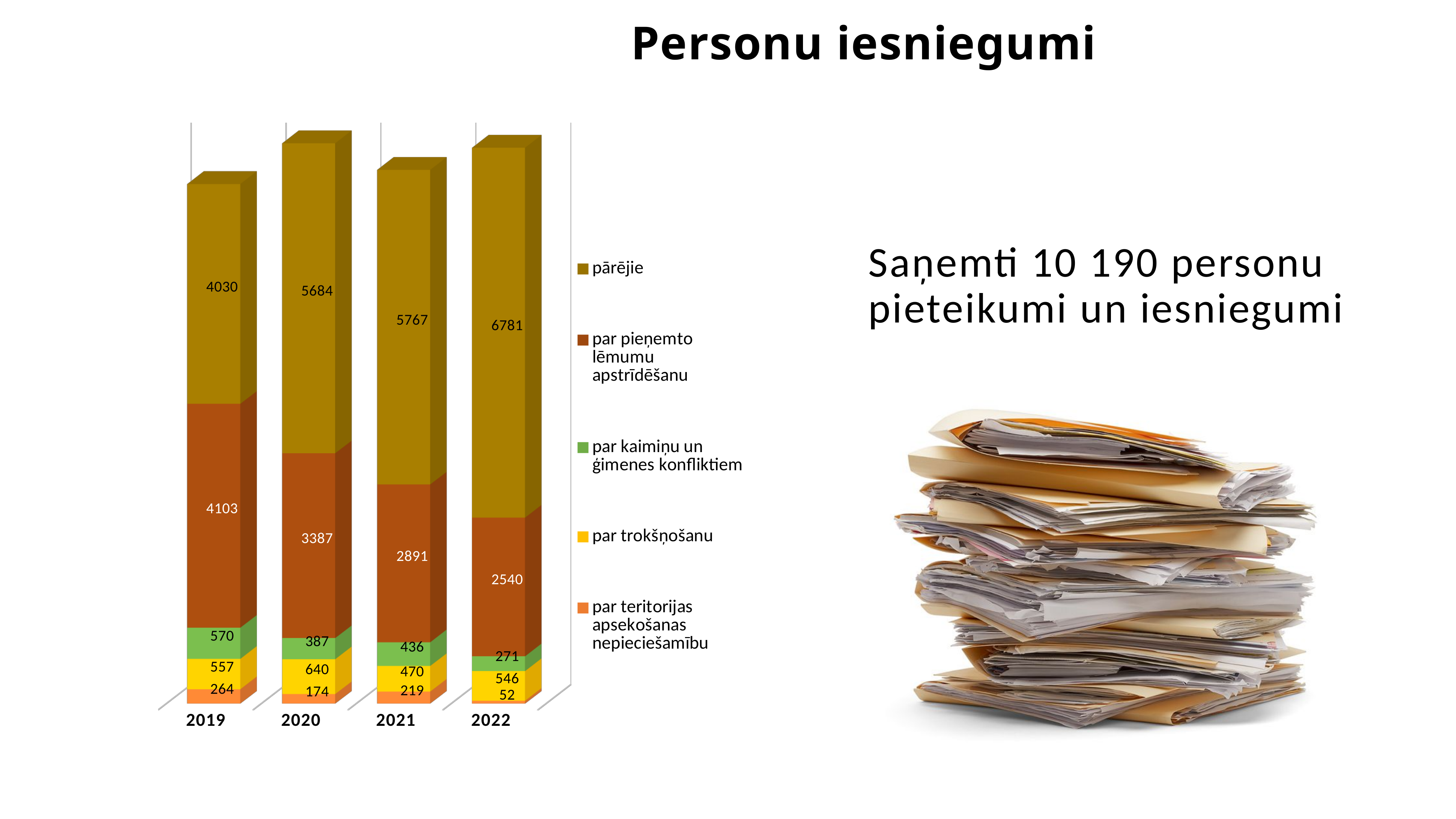
In which year is the value for "pārējie" highest? 2022 What is the difference between the "pārējie" values for 2022 and 2019? 2751 Which is larger: "par pieņemto lēmumu apstrīdēšanu" in 2020 or in 2021? 2020 How many years are shown on the x axis? 4 What is the value for "pārējie" in 2022? 6781 In which year is the value for "par kaimiņu un ģimenes konfliktiem" lowest? 2022 What is the total of the stacked bar for 2022? 10190 What kind of chart is shown on the slide? Stacked bar chart How many series does the legend list? 5 What is the value for "par pieņemto lēmumu apstrīdēšanu" in 2019? 4103 What is the value for "par trokšņošanu" in 2020? 640 What is the value for "par teritorijas apsekošanas nepieciešamību" in 2022? 52